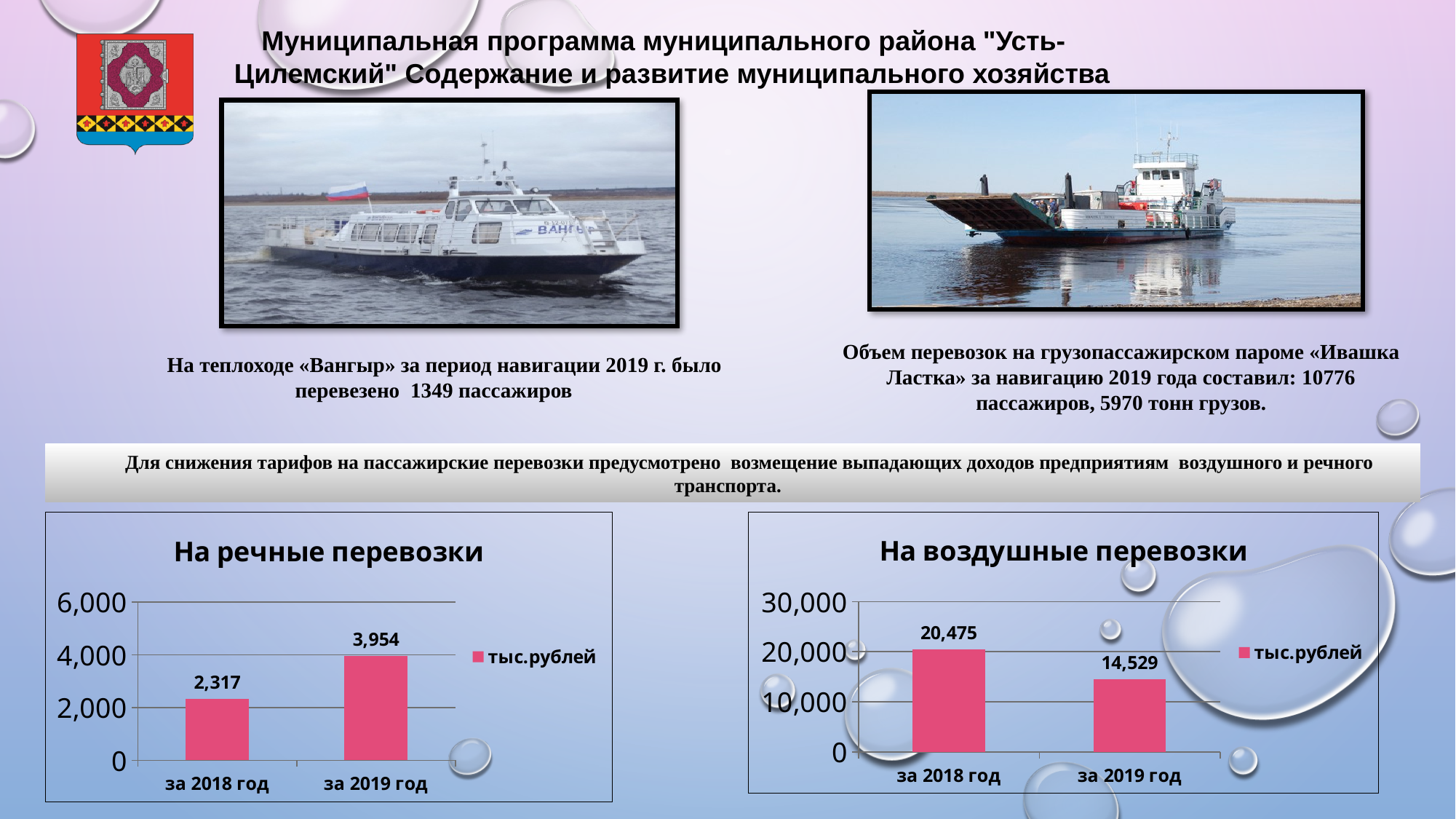
In the chart "На речные перевозки", what is the value for "за 2019 год"? 3,954 In the chart "На воздушные перевозки", do the values rise or fall from 2018 to 2019? fall In the chart "На речные перевозки", which year has the higher value? за 2019 год In the chart "На воздушные перевозки", what is the difference between the 2018 and 2019 values? 5,946 In the chart "На речные перевозки", is the value for "за 2019 год" greater or less than 4,000? less In the chart "На речные перевозки", what is the value for "за 2018 год"? 2,317 In the chart "На воздушные перевозки", which year has the lower value? за 2019 год In the chart "На воздушные перевозки", what is the value for "за 2018 год"? 20,475 In the chart "На воздушные перевозки", what is the value for "за 2019 год"? 14,529 What type of chart is "На речные перевозки"? bar chart How many categories are shown in the chart "На воздушные перевозки"? 2 In the chart "На речные перевозки", what is the difference between the 2019 and 2018 values? 1,637